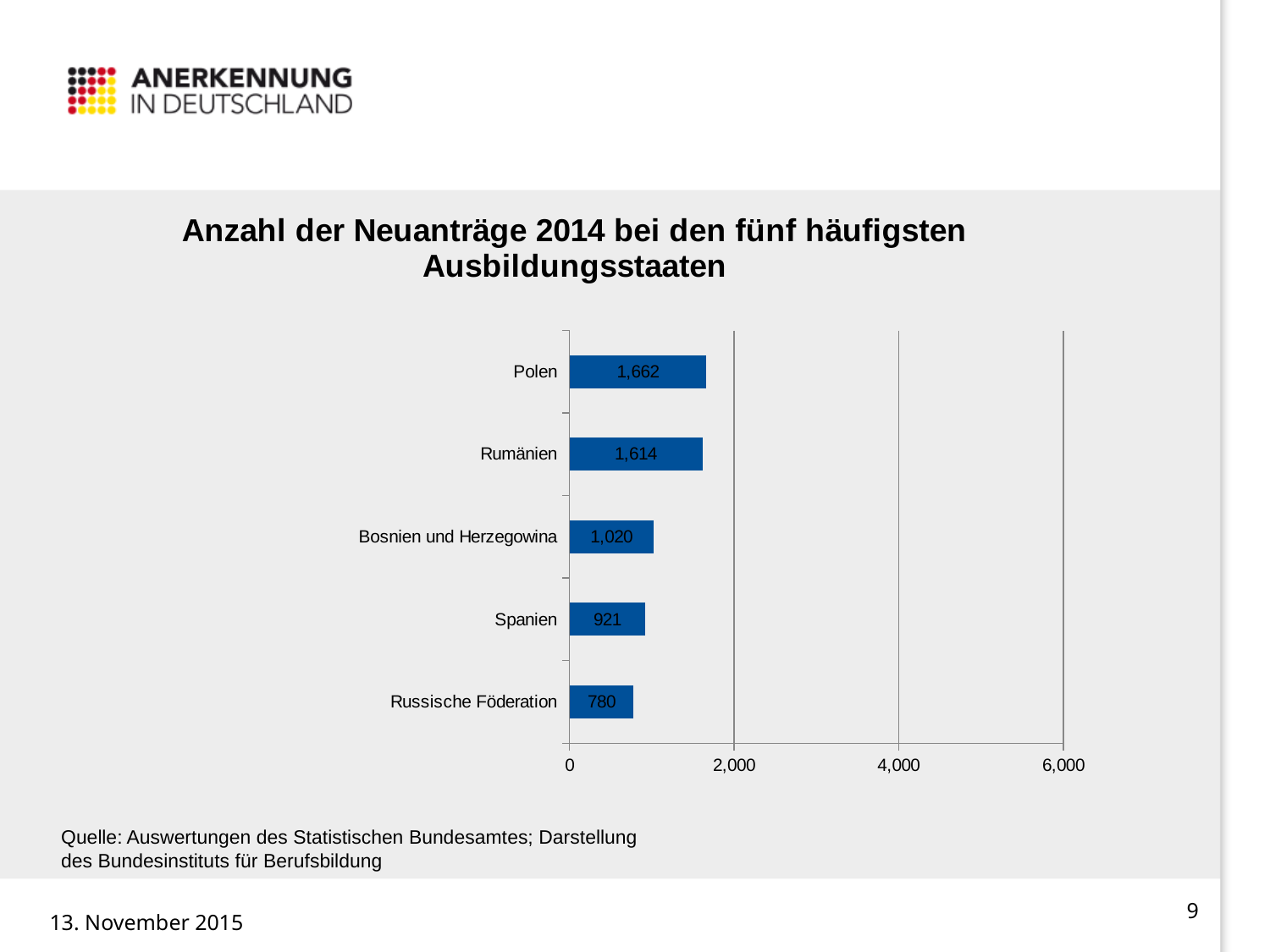
What is the difference between the values for Spanien and Russische Föderation? 141 How many countries are shown in the chart? 5 What is the difference between the values for Polen and Rumänien? 48 Which country has the lowest number of new applications? Russische Föderation Is the value for Rumänien greater or less than 2,000? less Which country has the highest number of new applications? Polen Which is larger, the value for Bosnien und Herzegowina or the value for Spanien? Bosnien und Herzegowina What is the value shown for Bosnien und Herzegowina? 1,020 What is the number of new applications for Polen? 1,662 What is the title of the chart? Anzahl der Neuanträge 2014 bei den fünf häufigsten Ausbildungsstaaten What is the value shown for Russische Föderation? 780 What kind of chart is shown on the slide? bar chart